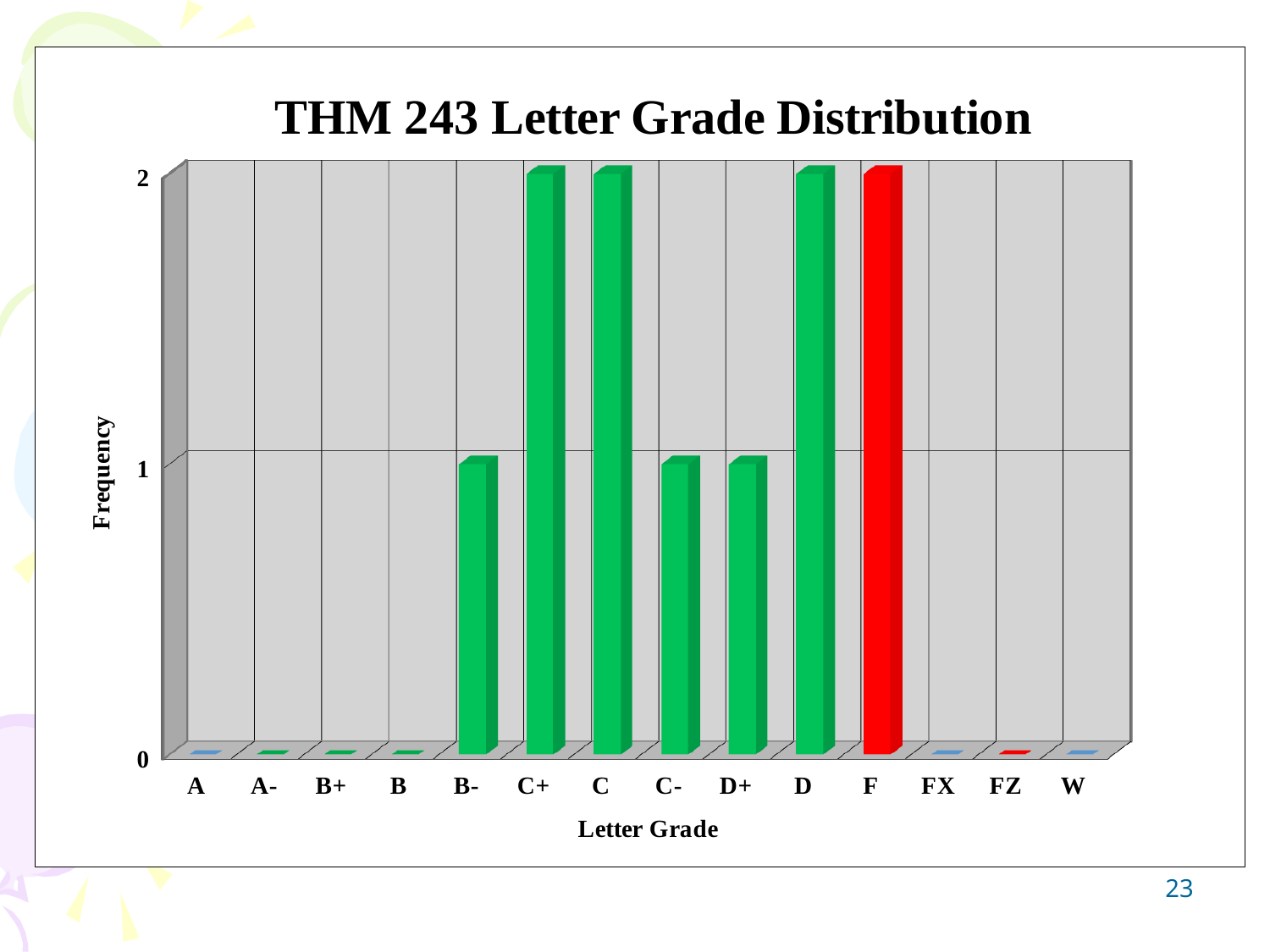
What is the difference in frequency between D and B-? 1 What is the frequency for letter grade C+? 2 What is the frequency for letter grade B-? 1 What is the title of the chart? THM 243 Letter Grade Distribution Which has the higher frequency, C+ or C-? C+ What is the label of the y axis? Frequency What is the frequency for letter grade F? 2 What is the frequency for letter grade A? 0 What kind of chart is shown on the slide? bar chart Which has the higher frequency, F or FX? F What is the frequency for letter grade D+? 1 How many letter grade categories are shown on the x axis? 14